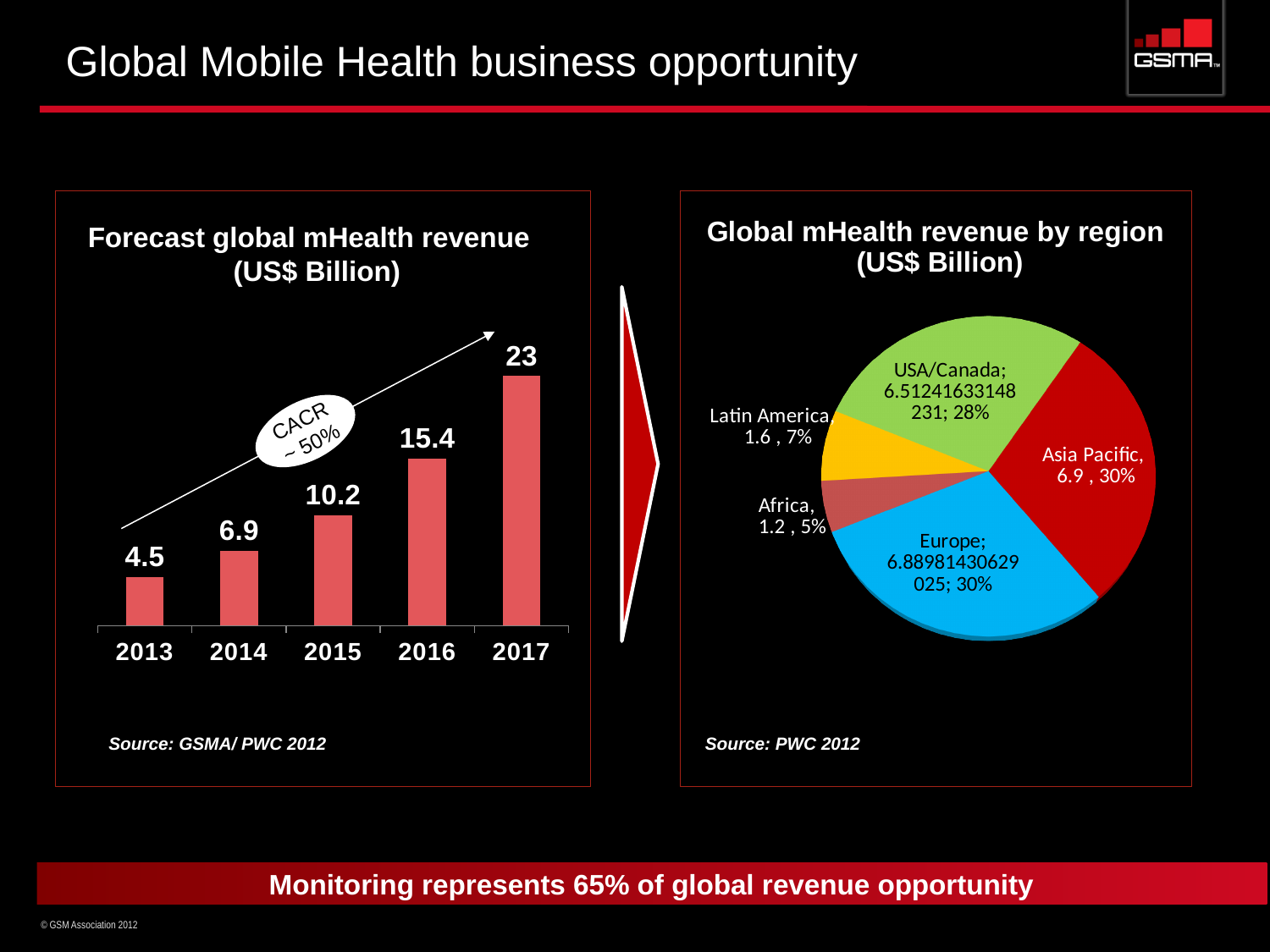
What kind of chart is 'Global mHealth revenue by region (US$ Billion)'? pie chart What kind of chart is 'Forecast global mHealth revenue (US$ Billion)'? bar chart In the 'Global mHealth revenue by region (US$ Billion)' chart, which region has the smallest share? Africa In the 'Forecast global mHealth revenue (US$ Billion)' chart, what is the value for 2015? 10.2 In the 'Forecast global mHealth revenue (US$ Billion)' chart, what is the value for 2017? 23 In the 'Global mHealth revenue by region (US$ Billion)' chart, how many regions are shown? 5 In the 'Forecast global mHealth revenue (US$ Billion)' chart, which year has the lowest value? 2013 In the 'Forecast global mHealth revenue (US$ Billion)' chart, how many years are shown? 5 In the 'Global mHealth revenue by region (US$ Billion)' chart, what is the value for Latin America? 1.6 In the 'Forecast global mHealth revenue (US$ Billion)' chart, do the values rise or fall from 2013 to 2017? rise In the 'Forecast global mHealth revenue (US$ Billion)' chart, what is the difference between the 2016 and 2014 values? 8.5 In the 'Global mHealth revenue by region (US$ Billion)' chart, what share of the pie does Asia Pacific represent? 30%